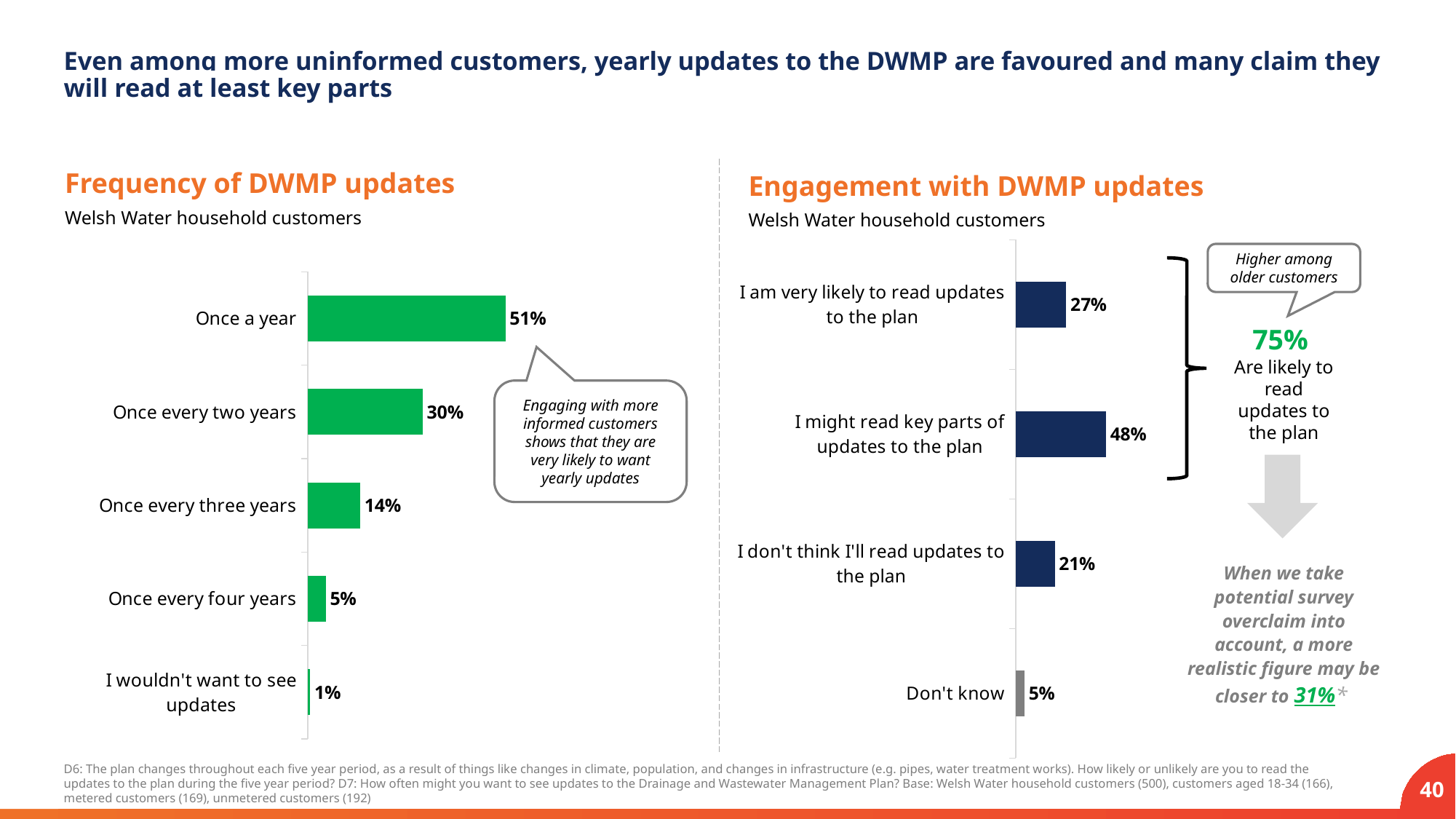
In the 'Frequency of DWMP updates' chart, what percentage of customers chose 'Once a year'? 51% In the 'Engagement with DWMP updates' chart, what is the combined value of 'I am very likely to read updates to the plan' and 'I might read key parts of updates to the plan'? 75% How many categories are shown in the 'Frequency of DWMP updates' chart? 5 In the 'Engagement with DWMP updates' chart, which is larger: 'I am very likely to read updates to the plan' or 'I don't think I'll read updates to the plan'? I am very likely to read updates to the plan What type of chart is the 'Frequency of DWMP updates' chart? Bar chart In the 'Engagement with DWMP updates' chart, what colour is the 'Don't know' bar? Grey In the 'Frequency of DWMP updates' chart, what is the difference between 'Once a year' and 'Once every two years'? 21 percentage points In the 'Frequency of DWMP updates' chart, what is the value for 'Once every three years'? 14% In the 'Engagement with DWMP updates' chart, what percentage said 'I don't think I'll read updates to the plan'? 21% In the 'Frequency of DWMP updates' chart, which category has the lowest value? I wouldn't want to see updates In the 'Engagement with DWMP updates' chart, what is the value for 'I might read key parts of updates to the plan'? 48% In the 'Engagement with DWMP updates' chart, which category has the highest value? I might read key parts of updates to the plan